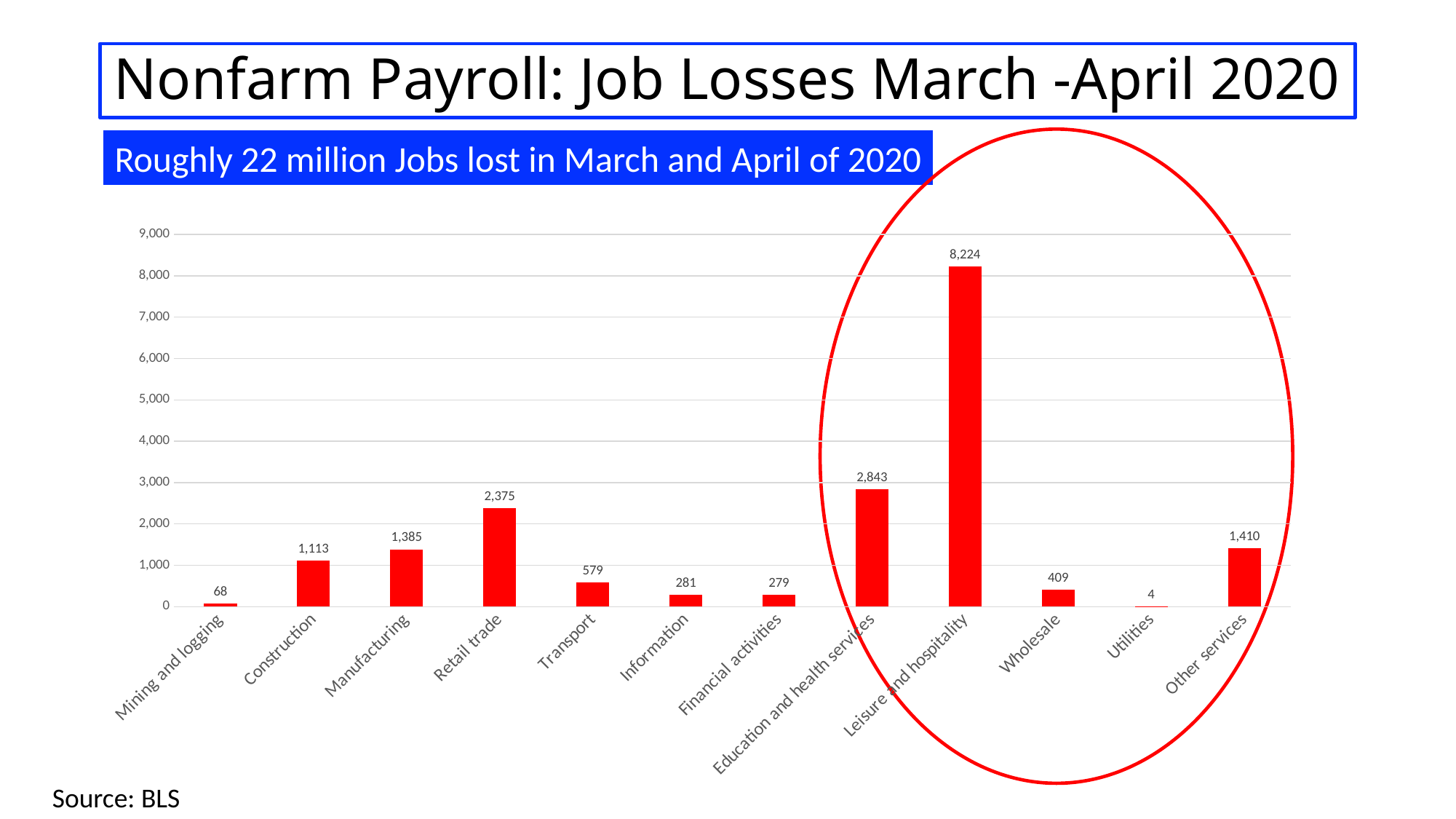
How many categories are shown on the x axis? 12 What kind of chart is shown? bar chart What is the difference between Leisure and hospitality and Education and health services? 5,381 What is the difference between Transport and Wholesale? 170 Which is larger, Manufacturing or Construction? Manufacturing Is the value for Other services greater or less than 1,000? greater What is the value for Retail trade? 2,375 What is the title of the slide? Nonfarm Payroll: Job Losses March -April 2020 Which category has the highest value? Leisure and hospitality What is the value for Leisure and hospitality? 8,224 Which category has the lowest value? Utilities What is the value for Utilities? 4